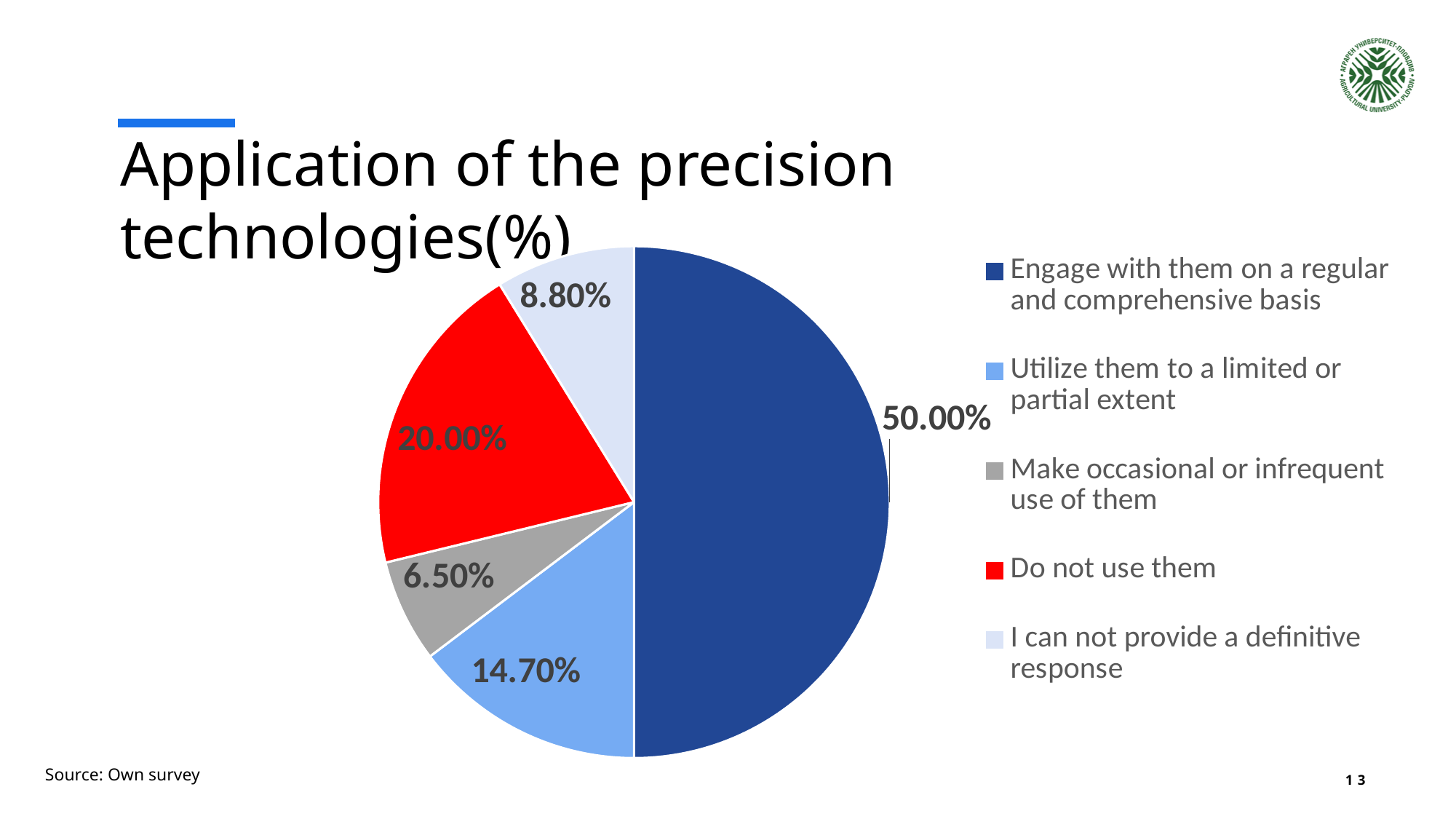
How many categories does the legend list? 5 What share of respondents do not use precision technologies? 20.00% What share of respondents utilize precision technologies to a limited or partial extent? 14.70% Which is larger: the share for 'Do not use them' or the share for 'I can not provide a definitive response'? Do not use them What kind of chart is shown on the slide? pie chart What is the difference in percentage points between 'Do not use them' and 'Utilize them to a limited or partial extent'? 5.30% Which category has the smallest slice of the pie? Make occasional or infrequent use of them What share of respondents make occasional or infrequent use of precision technologies? 6.50% What share of respondents could not provide a definitive response? 8.80% Which category has the largest slice of the pie? Engage with them on a regular and comprehensive basis What colour is the slice for 'Do not use them'? red What share of respondents engage with precision technologies on a regular and comprehensive basis? 50.00%